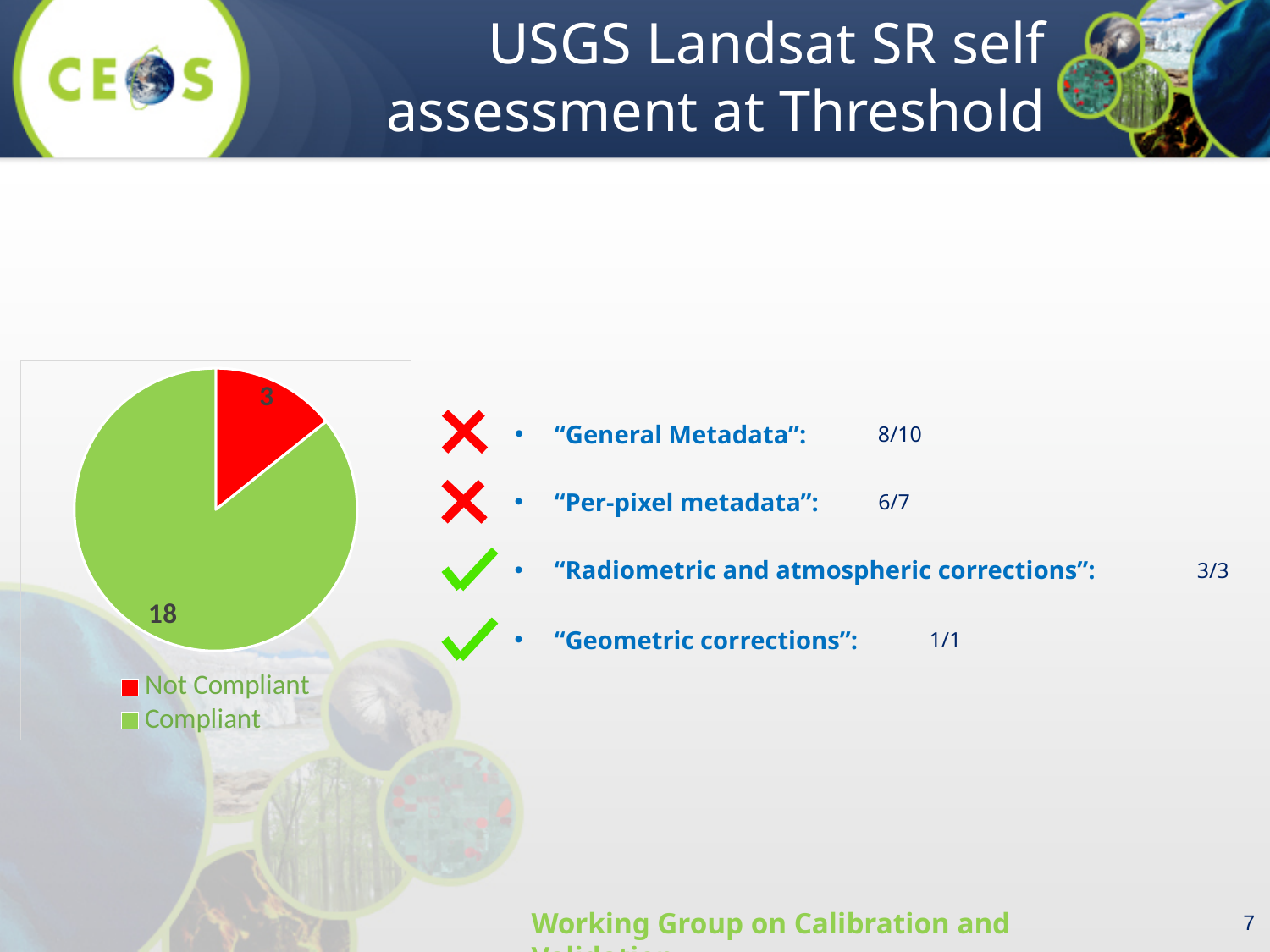
Which is larger in the pie chart, Compliant or Not Compliant? Compliant What is the value for Not Compliant in the pie chart? 3 What kind of chart is shown on the slide? pie chart What colour is the Not Compliant slice in the pie chart? red How many slices does the pie chart have? 2 Which slice of the pie chart is the largest? Compliant What colour is the Compliant slice in the pie chart? green How many entries does the pie chart legend list? 2 What is the value for Compliant in the pie chart? 18 Which slice of the pie chart is the smallest? Not Compliant What is the total of all slices in the pie chart? 21 What is the difference between the Compliant and Not Compliant values in the pie chart? 15